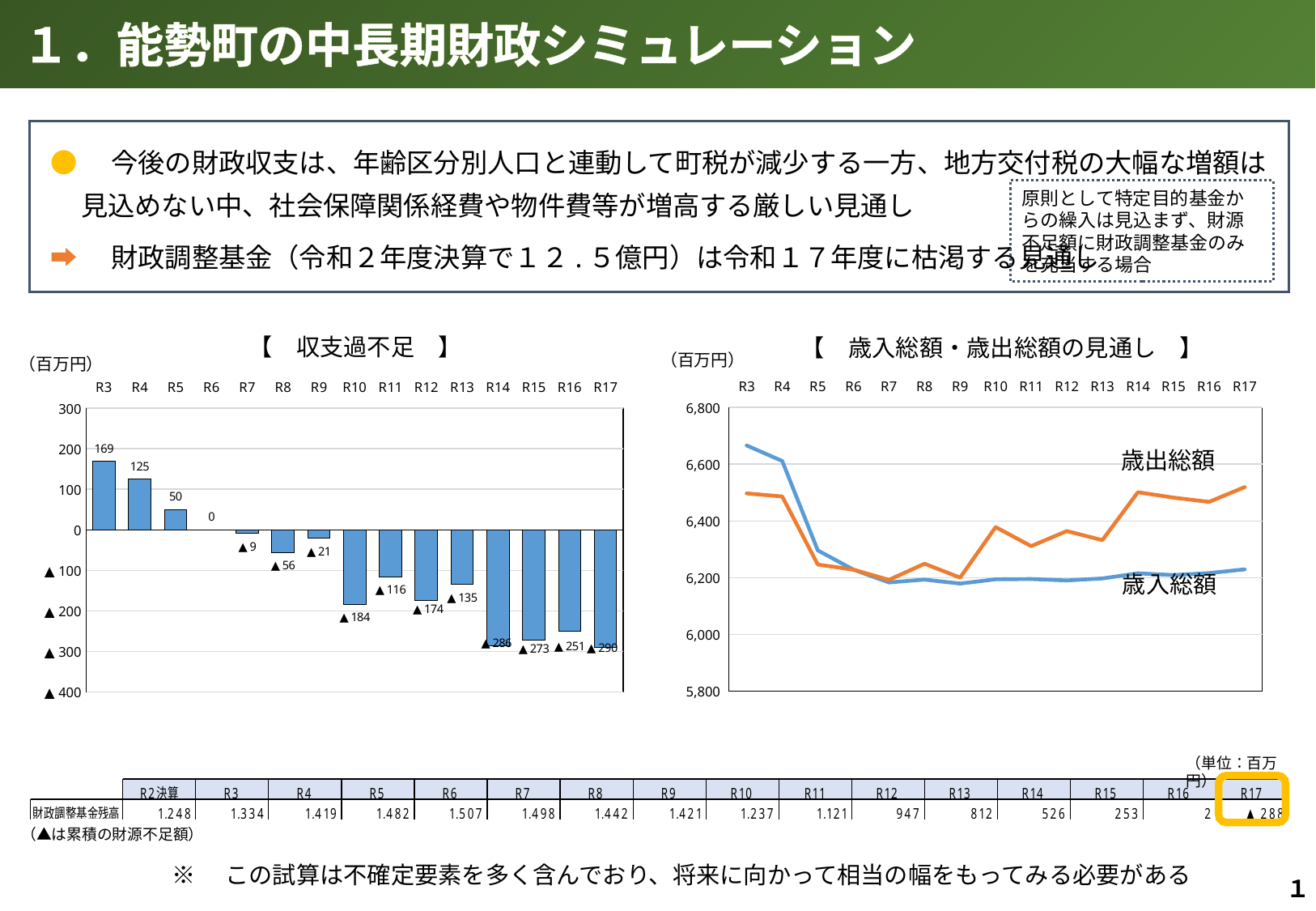
In the 収支過不足 chart, which year has the lowest value? R17 What kind of chart is the 収支過不足 chart? bar chart How many series are plotted in the 歳入総額・歳出総額の見通し chart? 2 In the 収支過不足 chart, what is the difference between the values for R3 and R4? 44 In the 収支過不足 chart, what is the value for R17? ▲290 In the 収支過不足 chart, which year has the highest value? R3 In the 歳入総額・歳出総額の見通し chart, is the value of 歳出総額 for R7 greater or less than 6,400? less In the 収支過不足 chart, what is the value for R10? ▲184 In the 収支過不足 chart, what is the value for R3? 169 In the 歳入総額・歳出総額の見通し chart, is the value of 歳入総額 for R3 greater or less than 6,600? greater In the 収支過不足 chart, which is larger, the value for R4 or the value for R5? R4 How many years are plotted in the 収支過不足 chart? 15